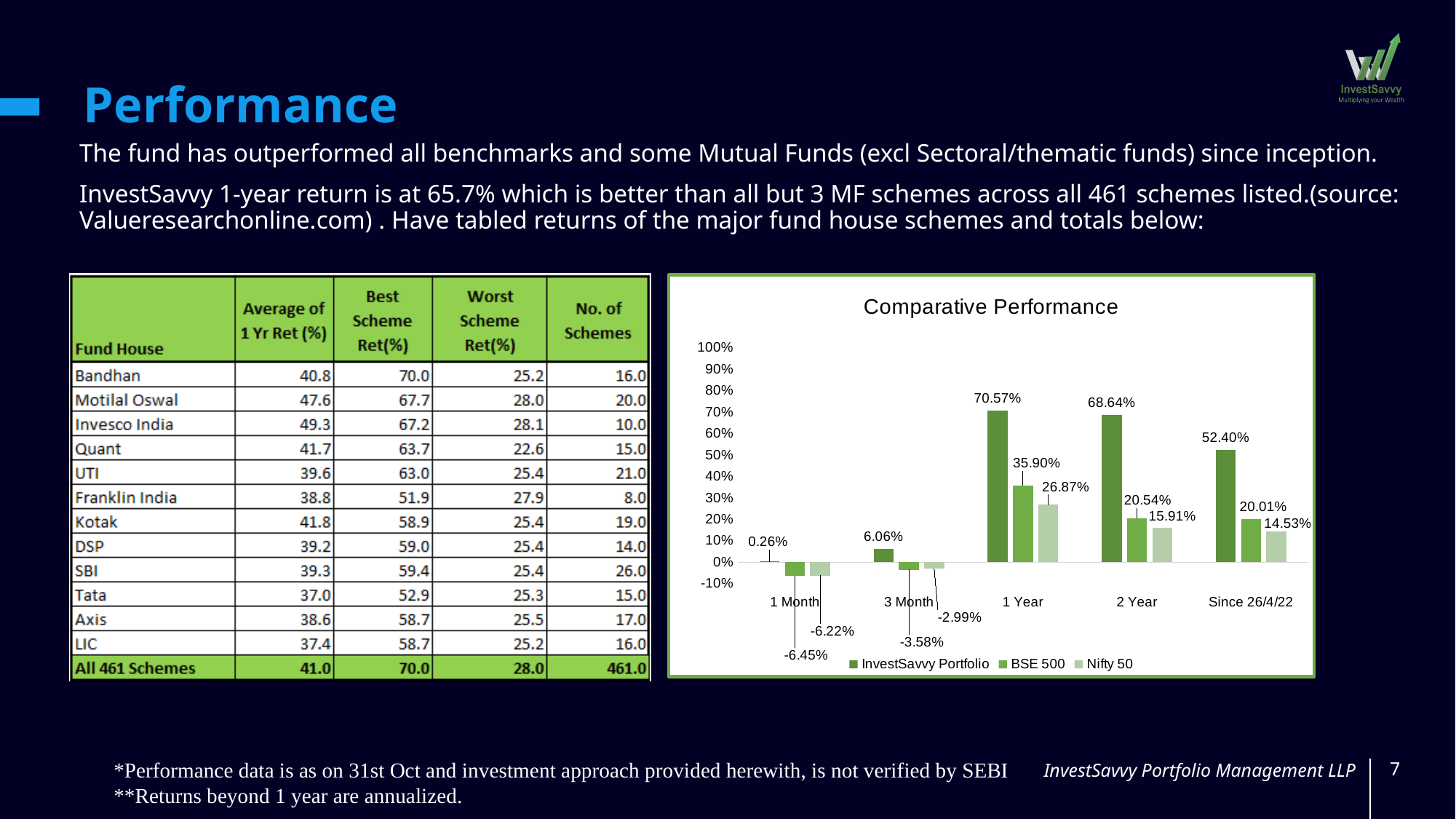
What is the Nifty 50 value for Since 26/4/22 in the Comparative Performance chart? 14.53% How many periods are shown on the x axis of the Comparative Performance chart? 5 Which period has the highest InvestSavvy Portfolio value in the Comparative Performance chart? 1 Year What is the BSE 500 value for 2 Year in the Comparative Performance chart? 20.54% For 3 Month, which is larger in the Comparative Performance chart: the BSE 500 value or the Nifty 50 value? Nifty 50 What are the three series listed in the legend of the Comparative Performance chart? InvestSavvy Portfolio, BSE 500, Nifty 50 Which period has the lowest Nifty 50 value in the Comparative Performance chart? 1 Month What type of chart is the Comparative Performance chart? Bar chart What is the BSE 500 value for 1 Month in the Comparative Performance chart? -6.45% How many series does the legend of the Comparative Performance chart list? 3 What is the difference between the InvestSavvy Portfolio and BSE 500 values for 1 Year in the Comparative Performance chart? 34.67% What is the InvestSavvy Portfolio value for 1 Year in the Comparative Performance chart? 70.57%